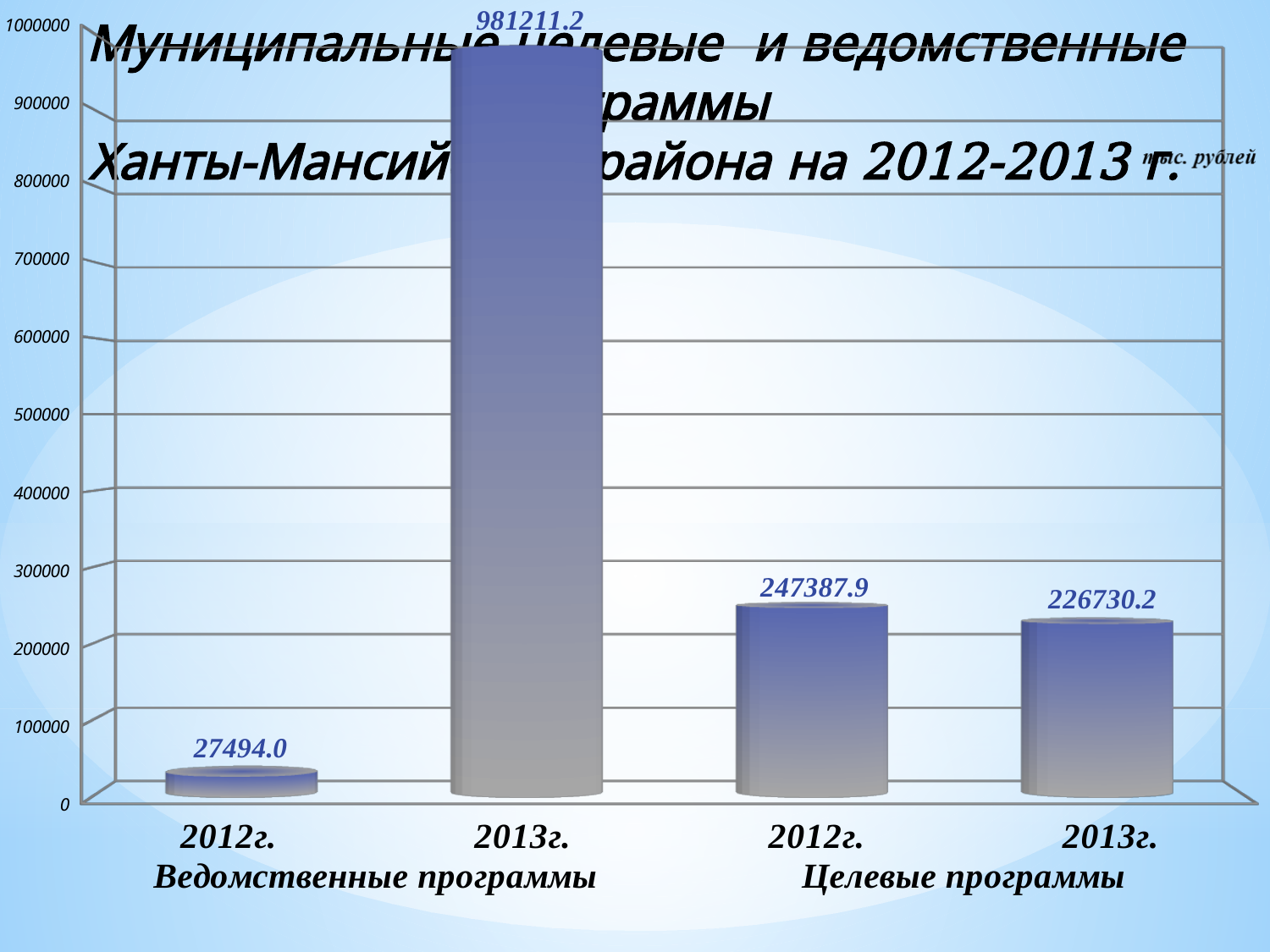
What is the difference between Целевые программы in 2012г. and 2013г.? 20657.7 By how much did Ведомственные программы increase from 2012г. to 2013г.? 953717.2 Which bar has the lowest value on the chart? Ведомственные программы, 2012г. What is the value for Ведомственные программы in 2012г.? 27494.0 In what units are the values on the chart expressed, according to the label at the top right? тыс. рублей What is the value for Целевые программы in 2012г.? 247387.9 What type of chart is shown on the slide? Bar chart Which is larger: Целевые программы in 2012г. or in 2013г.? 2012г. What is the value for Целевые программы in 2013г.? 226730.2 How many bars are plotted on the chart? 4 Which bar has the highest value on the chart? Ведомственные программы, 2013г. What is the value for Ведомственные программы in 2013г.? 981211.2